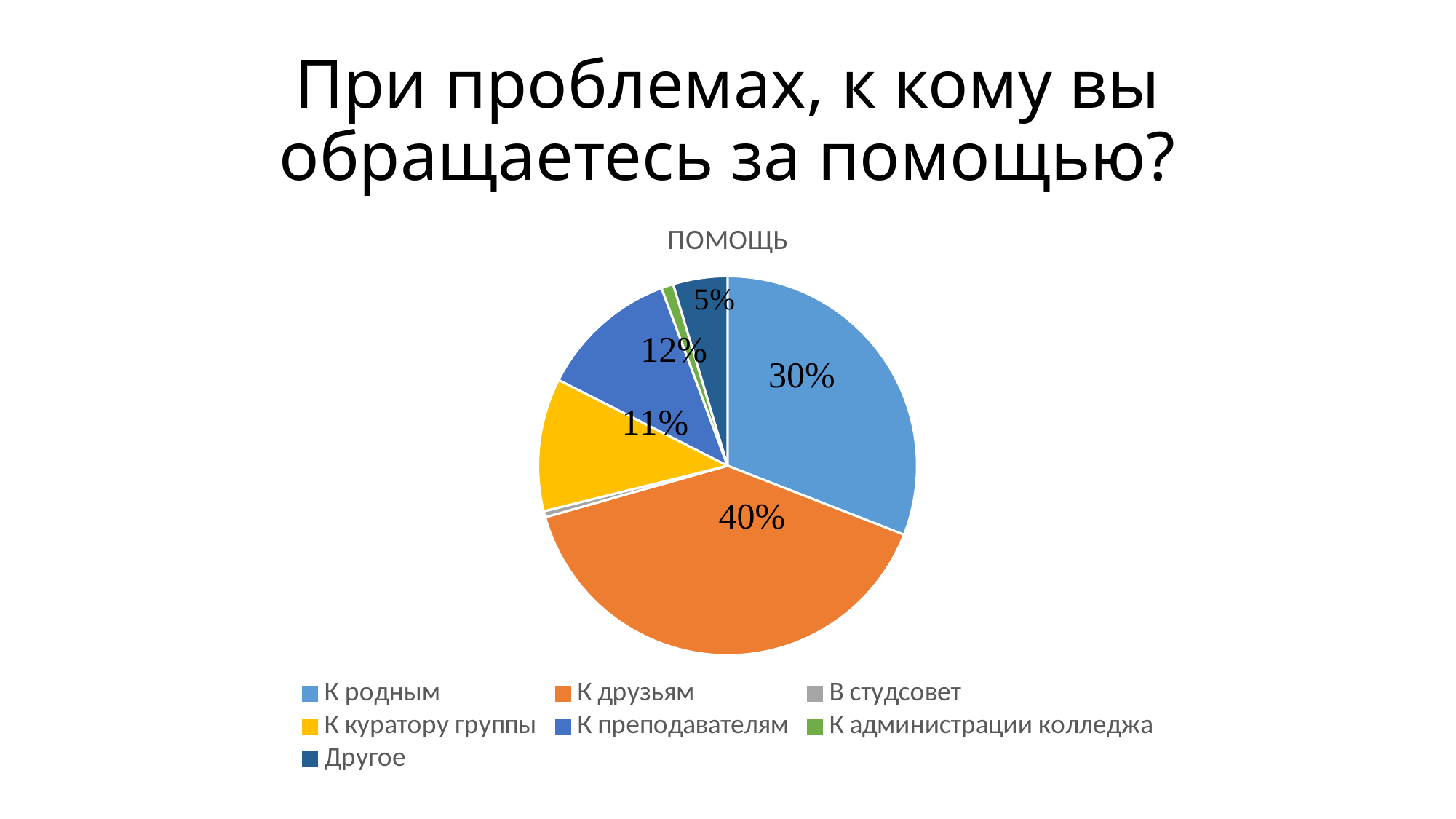
Which is larger, К родным or Другое? К родным What is the title of the chart? ПОМОЩЬ What share of the pie does К куратору группы have? 11% How many categories does the legend list? 7 What share of the pie does К преподавателям have? 12% Which is larger, К преподавателям or К куратору группы? К преподавателям Which category has the largest slice of the pie? К друзьям What is the difference in percentage points between К друзьям and К родным? 10 What kind of chart is shown on the slide? Pie chart What share of the pie does Другое have? 5% What share of the pie does К родным have? 30% What share of the pie does К друзьям have? 40%